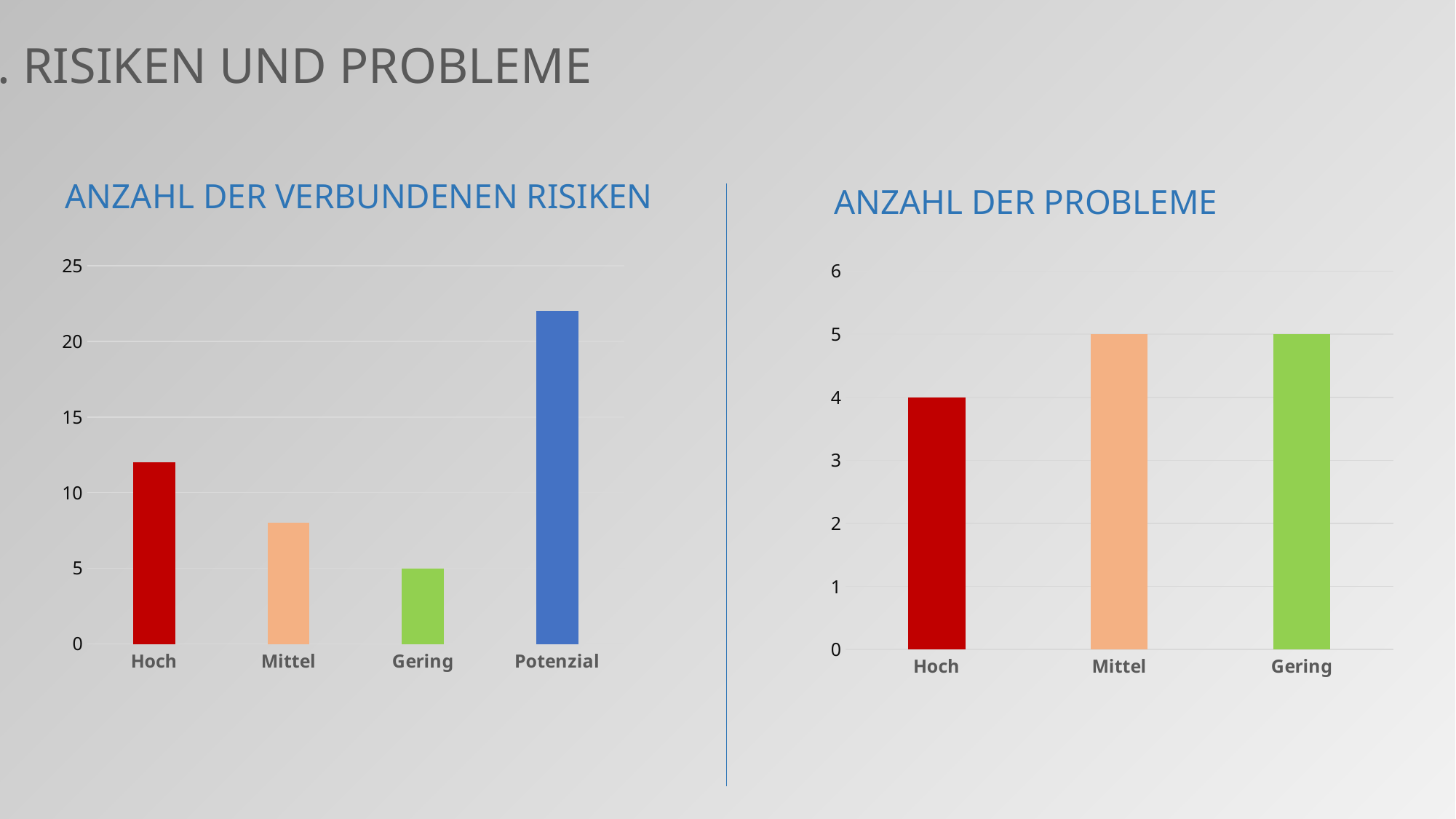
In the chart titled 'ANZAHL DER VERBUNDENEN RISIKEN', which category has the lowest value? Gering In the chart titled 'ANZAHL DER VERBUNDENEN RISIKEN', which category has the highest value? Potenzial What kind of chart is the chart titled 'ANZAHL DER PROBLEME'? bar chart In the chart titled 'ANZAHL DER VERBUNDENEN RISIKEN', is the value for Mittel greater or less than 10? less In the chart titled 'ANZAHL DER VERBUNDENEN RISIKEN', is the value for Potenzial greater or less than 20? greater In the chart titled 'ANZAHL DER VERBUNDENEN RISIKEN', is the value for Hoch greater or less than 10? greater In the chart titled 'ANZAHL DER PROBLEME', what is the value for Hoch? 4 In the chart titled 'ANZAHL DER PROBLEME', what is the difference between the values for Mittel and Hoch? 1 In the chart titled 'ANZAHL DER PROBLEME', what is the value for Mittel? 5 In the chart titled 'ANZAHL DER VERBUNDENEN RISIKEN', how many categories are shown? 4 In the chart titled 'ANZAHL DER VERBUNDENEN RISIKEN', what is the value for Gering? 5 In the chart titled 'ANZAHL DER PROBLEME', which category has the lowest value? Hoch